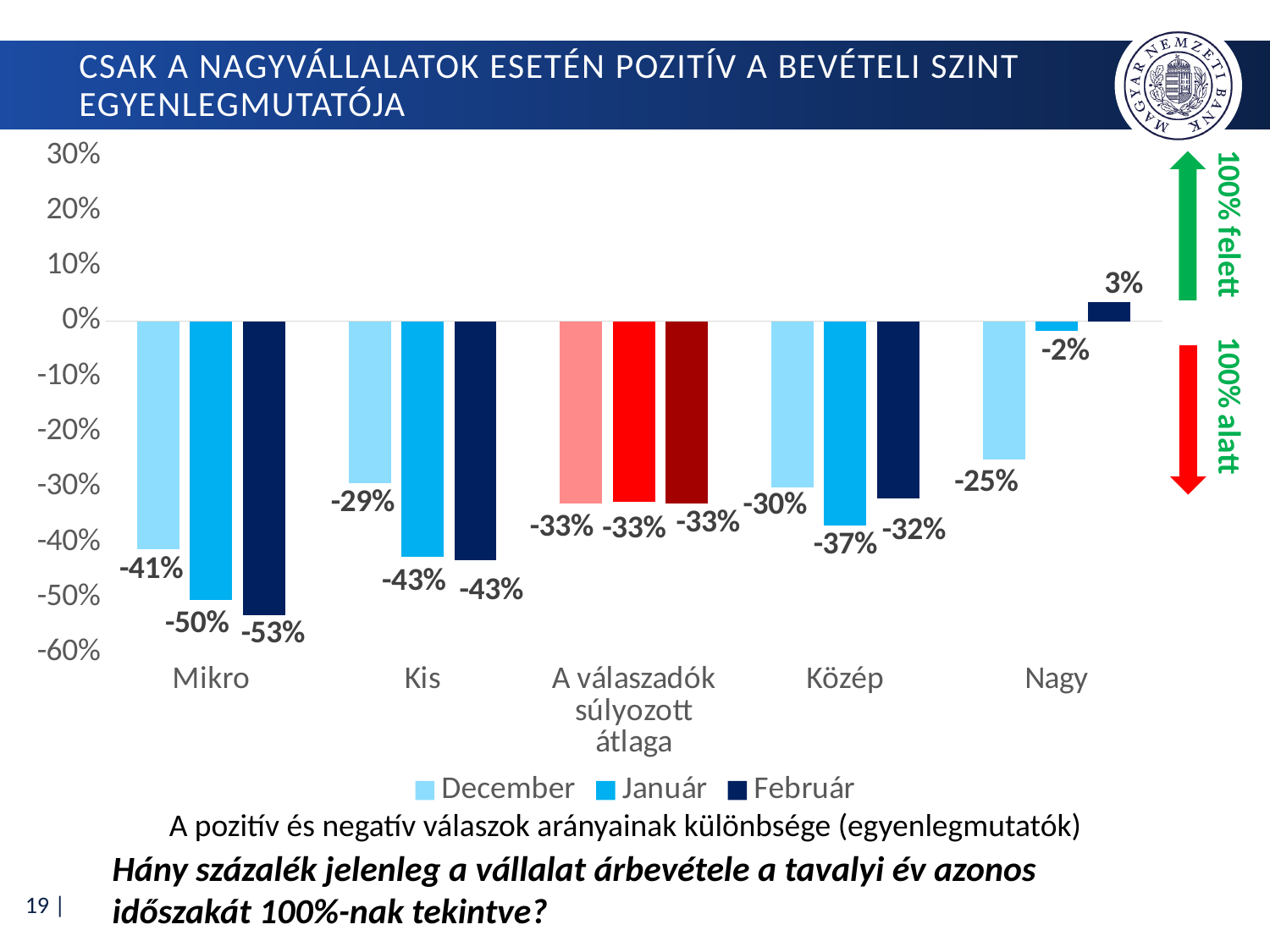
What is the Február value for Mikro? -53% Which category has the lowest Január value? Mikro How many categories are shown on the x axis? 5 Which is larger, the Január value for Kis or the Január value for Közép? Közép What is the difference between the December and Február values for Mikro? 12 percentage points What is the December value for Közép? -30% Which category is the only one with a positive value? Nagy Is the December value for Kis greater or less than -20%? less Which category has the highest Február value? Nagy How many series does the legend list? 3 What is the Január value for Nagy? -2% What kind of chart is shown on the slide? bar chart